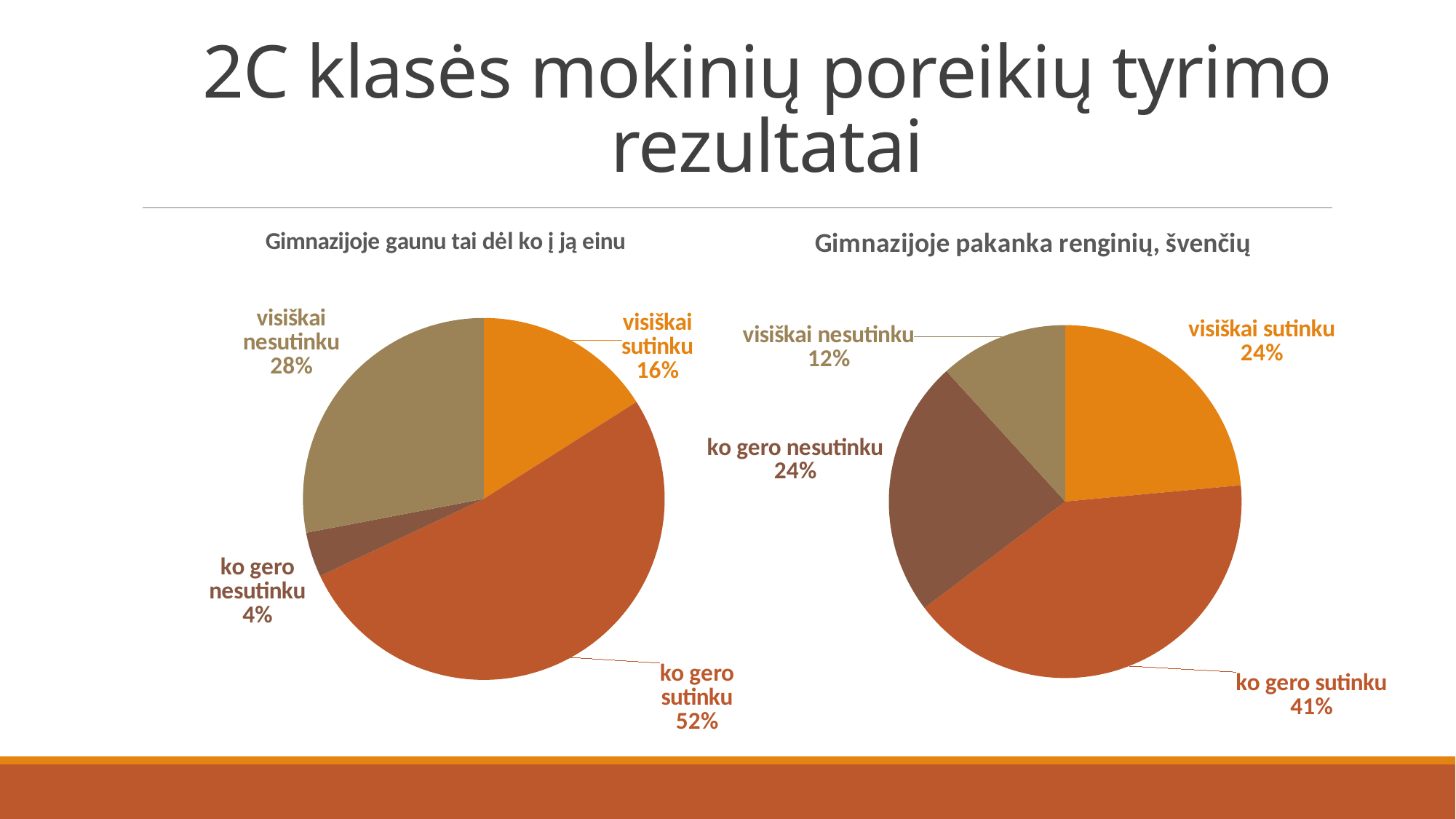
In the chart titled "Gimnazijoje gaunu tai dėl ko į ją einu", what share is labelled for "visiškai nesutinku"? 28% How many slices does the chart titled "Gimnazijoje gaunu tai dėl ko į ją einu" have? 4 In the chart titled "Gimnazijoje gaunu tai dėl ko į ją einu", which category has the smallest slice? ko gero nesutinku In the chart titled "Gimnazijoje gaunu tai dėl ko į ją einu", what is the difference between the shares for "visiškai nesutinku" and "visiškai sutinku"? 12% In the chart titled "Gimnazijoje pakanka renginių, švenčių", which is larger: "visiškai sutinku" or "visiškai nesutinku"? visiškai sutinku In the chart titled "Gimnazijoje pakanka renginių, švenčių", what share is labelled for "visiškai nesutinku"? 12% In the chart titled "Gimnazijoje pakanka renginių, švenčių", what share is labelled for "ko gero sutinku"? 41% In the chart titled "Gimnazijoje pakanka renginių, švenčių", which category has the largest slice? ko gero sutinku What type of chart is the chart titled "Gimnazijoje pakanka renginių, švenčių"? pie chart In the chart titled "Gimnazijoje gaunu tai dėl ko į ją einu", what share is labelled for "ko gero sutinku"? 52% In the chart titled "Gimnazijoje gaunu tai dėl ko į ją einu", which category has the largest slice? ko gero sutinku In the chart titled "Gimnazijoje pakanka renginių, švenčių", what is the difference between the shares for "ko gero sutinku" and "ko gero nesutinku"? 17%